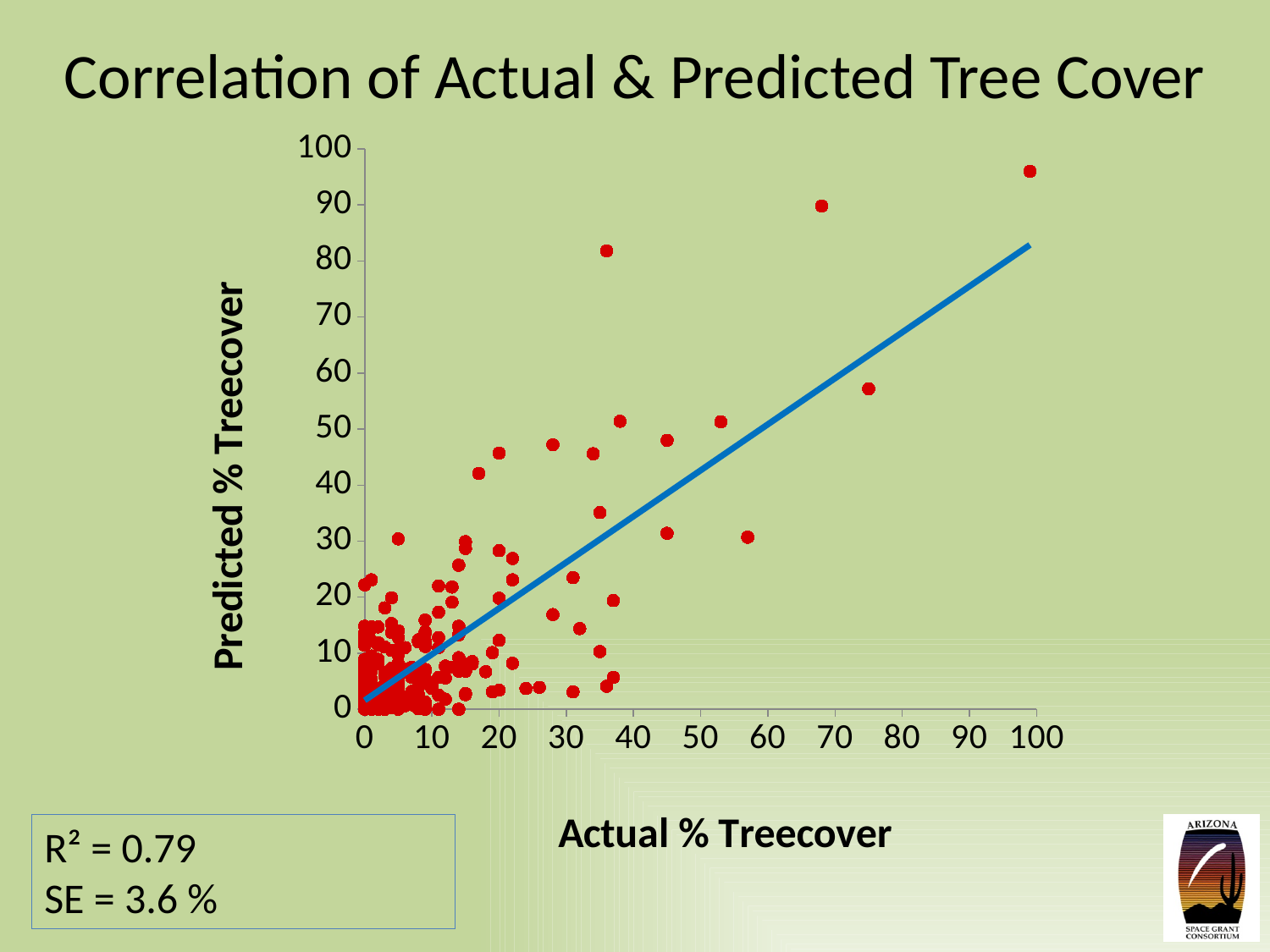
Does the trend line slope upward or downward as actual % treecover increases? upward Does the point with the highest predicted % treecover also have the highest actual % treecover? Yes Is the predicted % treecover for the point at roughly 57% actual treecover greater or less than 40? less Is the predicted % treecover for the point at roughly 75% actual treecover greater or less than 50? greater What is the label of the x axis? Actual % Treecover Is the predicted % treecover for the point at roughly 68% actual treecover greater or less than 80? greater Which point has a higher predicted % treecover: the one near 68% actual or the one near 75% actual? the one near 68% actual What kind of chart is shown on the slide? scatter chart What is the title of the chart? Correlation of Actual & Predicted Tree Cover